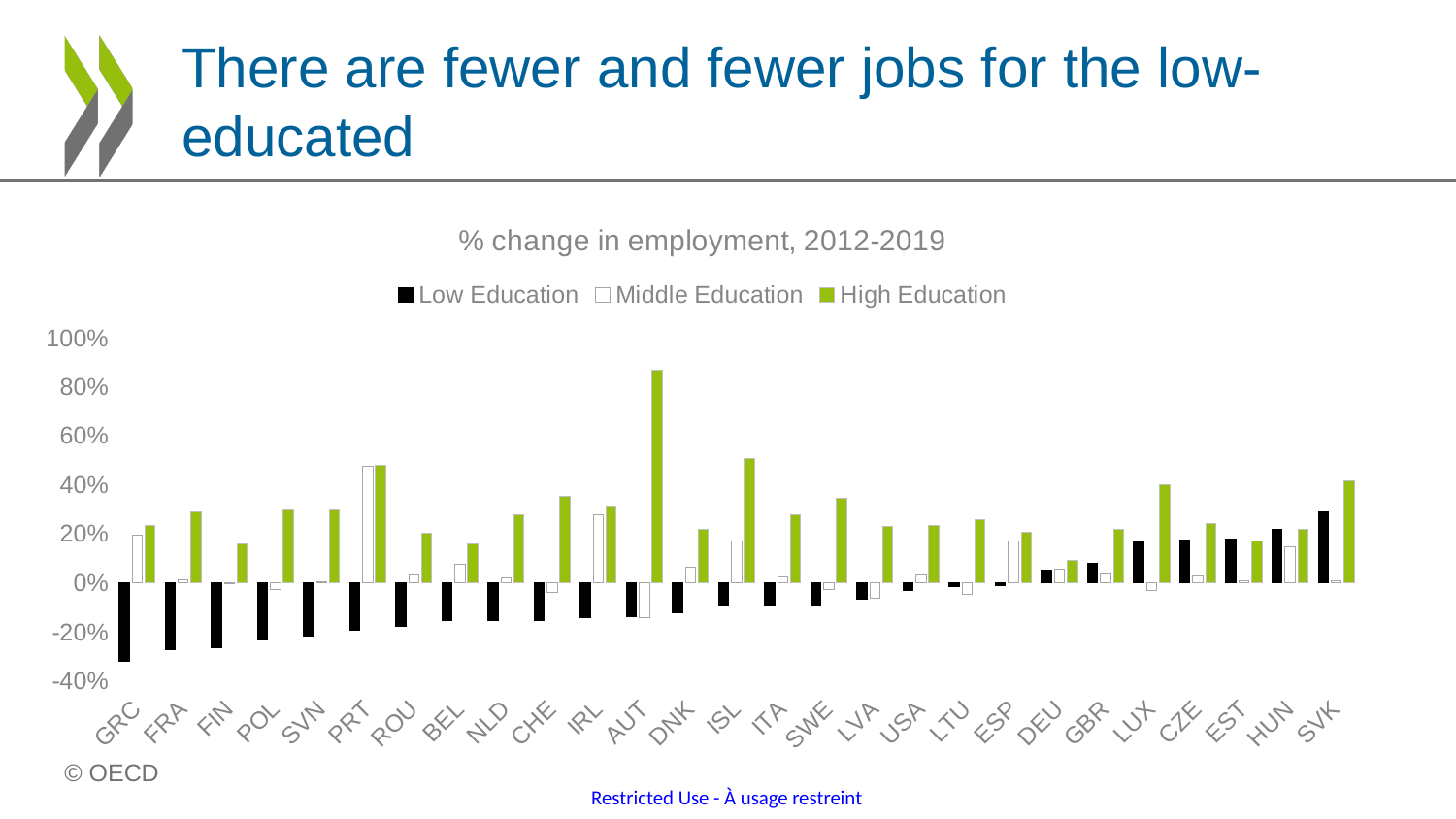
What kind of chart is shown on the slide? bar chart Is the High Education value for DNK greater or less than 80%? less Is the Middle Education value for PRT greater or less than 40%? greater Is the Low Education value for GRC greater or less than -20%? less Which country has the highest Low Education value? SVK Which country has the highest High Education value? AUT Which is larger, the High Education value for DNK or for ISL? ISL How many countries are shown on the x axis? 27 Do the Low Education values generally rise or fall moving from left to right along the x axis? rise Which country has the lowest Low Education value? GRC How many series does the legend list? 3 What is the title of the chart? % change in employment, 2012-2019